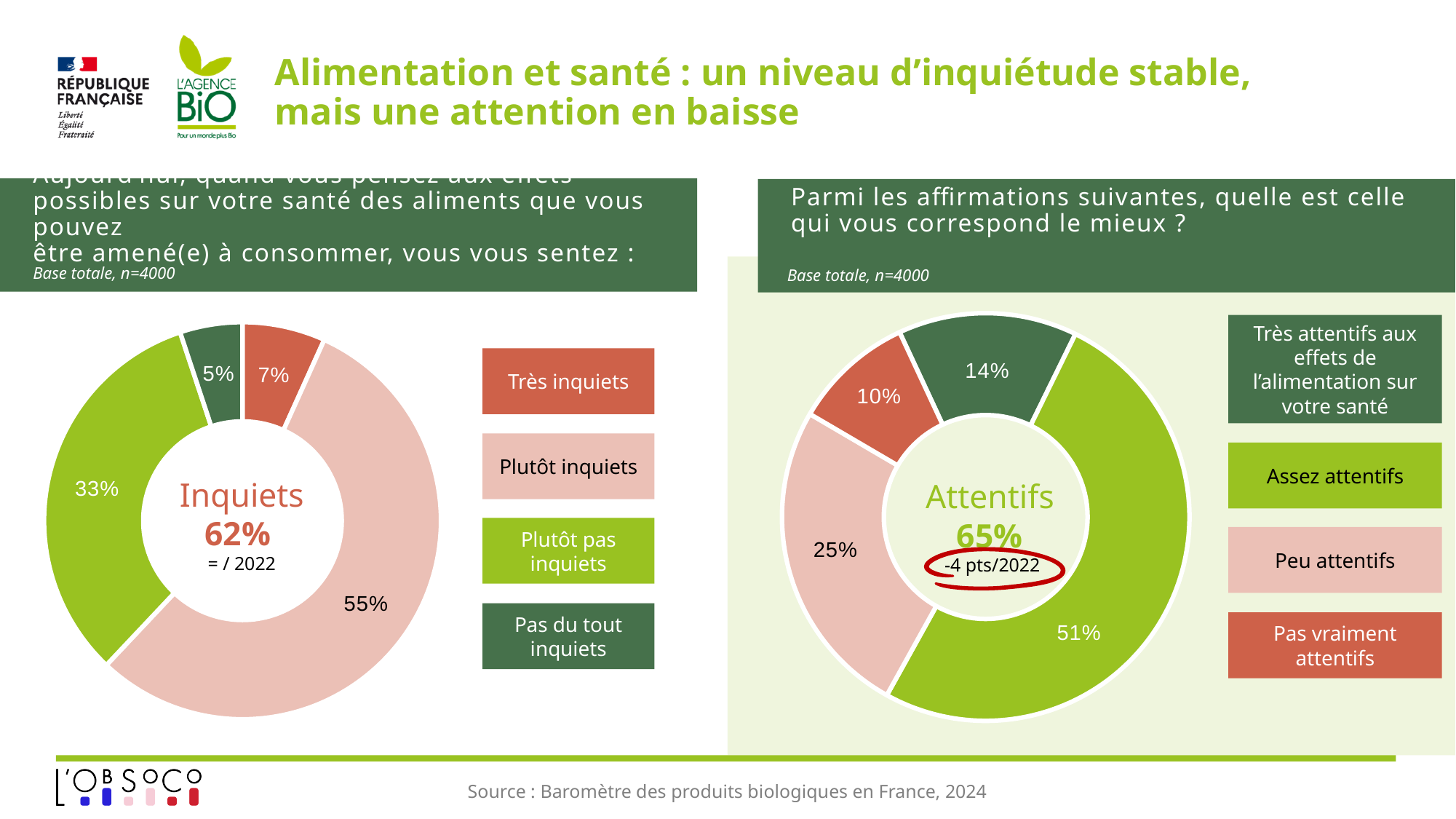
In the left donut chart (Inquiets), what is the difference in percentage points between 'Plutôt inquiets' and 'Plutôt pas inquiets'? 22 In the left donut chart (Inquiets), what total percentage is shown in the centre of the donut? 62% How many categories does the legend of the right donut chart (Attentifs) list? 4 In the left donut chart (Inquiets), what percentage of respondents are 'Plutôt inquiets'? 55% In the right donut chart (Attentifs), which is larger: 'Très attentifs aux effets de l'alimentation sur votre santé' or 'Peu attentifs'? Peu attentifs In the right donut chart (Attentifs), what change versus 2022 is indicated under the 65% figure? -4 pts/2022 In the left donut chart (Inquiets), which category has the smallest share? Pas du tout inquiets In the right donut chart (Attentifs), what percentage of respondents are 'Assez attentifs'? 51% In the right donut chart (Attentifs), what percentage of respondents are 'Pas vraiment attentifs'? 10% In the left donut chart (Inquiets), what percentage of respondents are 'Très inquiets'? 7% What type of chart is used on the left side of the slide (Inquiets)? Donut (pie) chart In the right donut chart (Attentifs), which category has the largest share? Assez attentifs